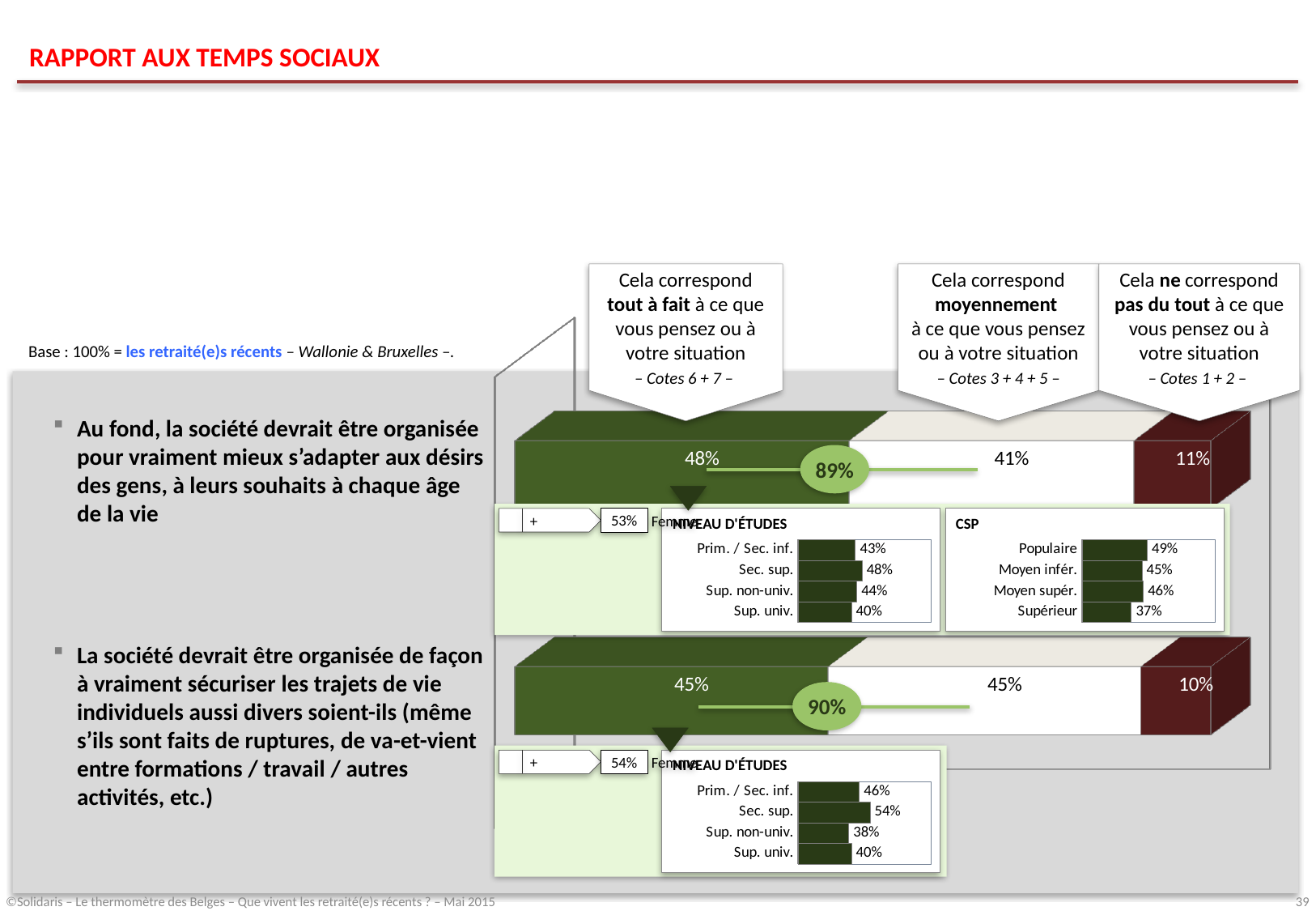
In the top stacked bar (about society adapting to people's desires at every age), what percentage corresponds to 'Cela ne correspond pas du tout'? 11% In the 'CSP' chart, what is the value for 'Populaire'? 49% How many categories are shown in the 'CSP' chart? 4 In the bottom stacked bar (about securing individual life paths), what is the combined share of 'tout à fait' and 'moyennement' shown in the green circle? 90% In the top 'NIVEAU D'ÉTUDES' chart, what is the value for 'Sup. univ.'? 40% In the top stacked bar (about society adapting to people's desires at every age), what percentage corresponds to 'Cela correspond tout à fait'? 48% In the 'CSP' chart, which category has the lowest value? Supérieur In the top 'NIVEAU D'ÉTUDES' chart, which education level has the highest value? Sec. sup. In the bottom stacked bar (about securing individual life paths), what percentage corresponds to 'Cela correspond moyennement'? 45% In the top stacked bar, what is the difference between the 'tout à fait' share and the 'moyennement' share? 7 points In the bottom 'NIVEAU D'ÉTUDES' chart, what is the difference between 'Sec. sup.' and 'Sup. univ.'? 14 points In the bottom 'NIVEAU D'ÉTUDES' chart, which is larger: 'Sec. sup.' or 'Sup. non-univ.'? Sec. sup.